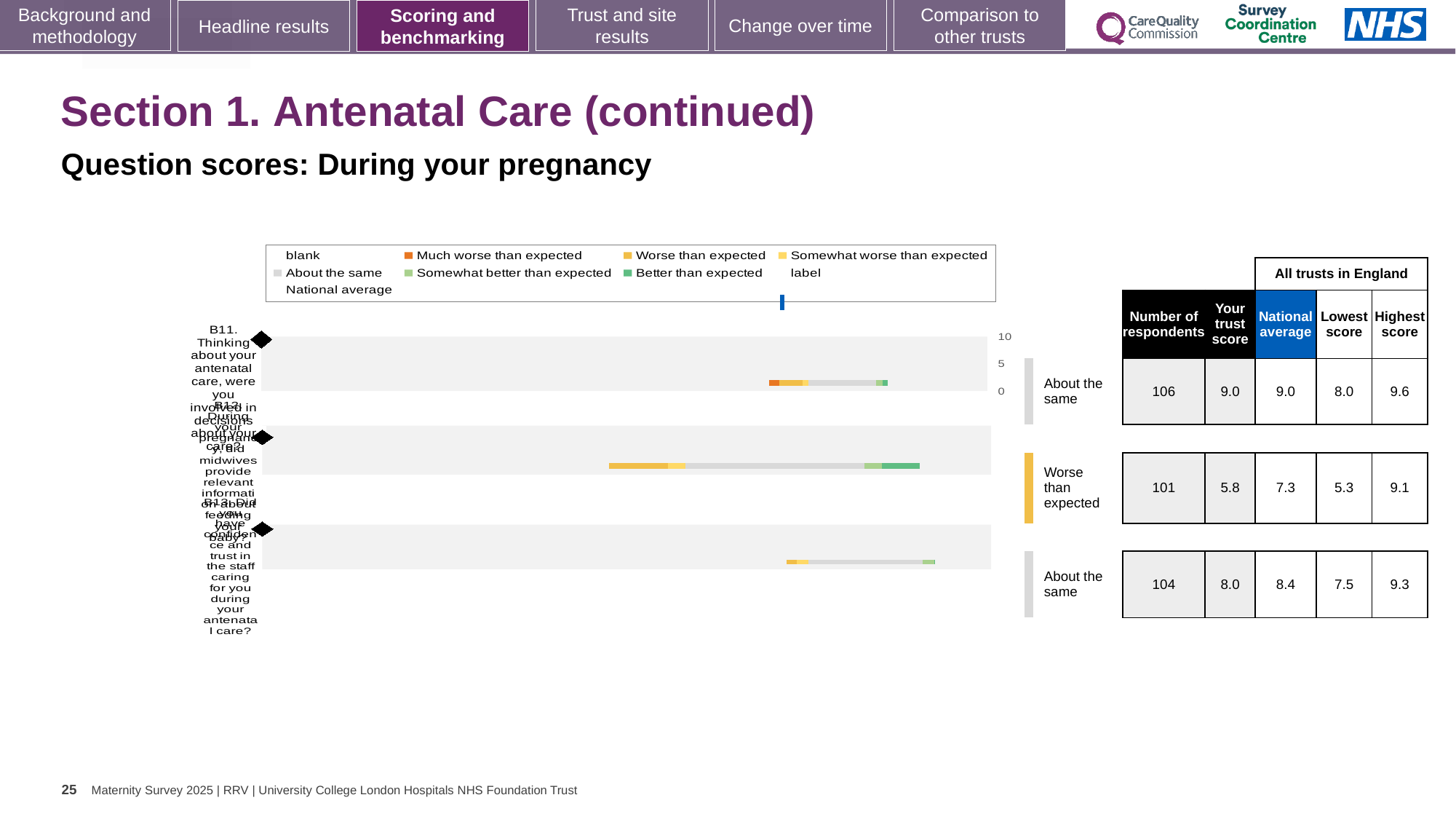
What is the number of respondents for the first question, B11? 106 For question B12, how much higher is the national average than the trust score? 1.5 What benchmark category is shown for question B12? Worse than expected What is the trust score for the second question, B12? 5.8 What kind of chart is shown on the slide? bar chart For question B12, what is the difference between the highest score and the lowest score across all trusts in England? 3.8 For question B13, which is larger: the trust score or the national average? national average Which question has the highest trust score? B11 Which question has the lowest trust score? B12 What is the national average for the third question, B13? 8.4 What is the highest score across all trusts in England for question B11? 9.6 How many questions (categories) are plotted in the chart? 3